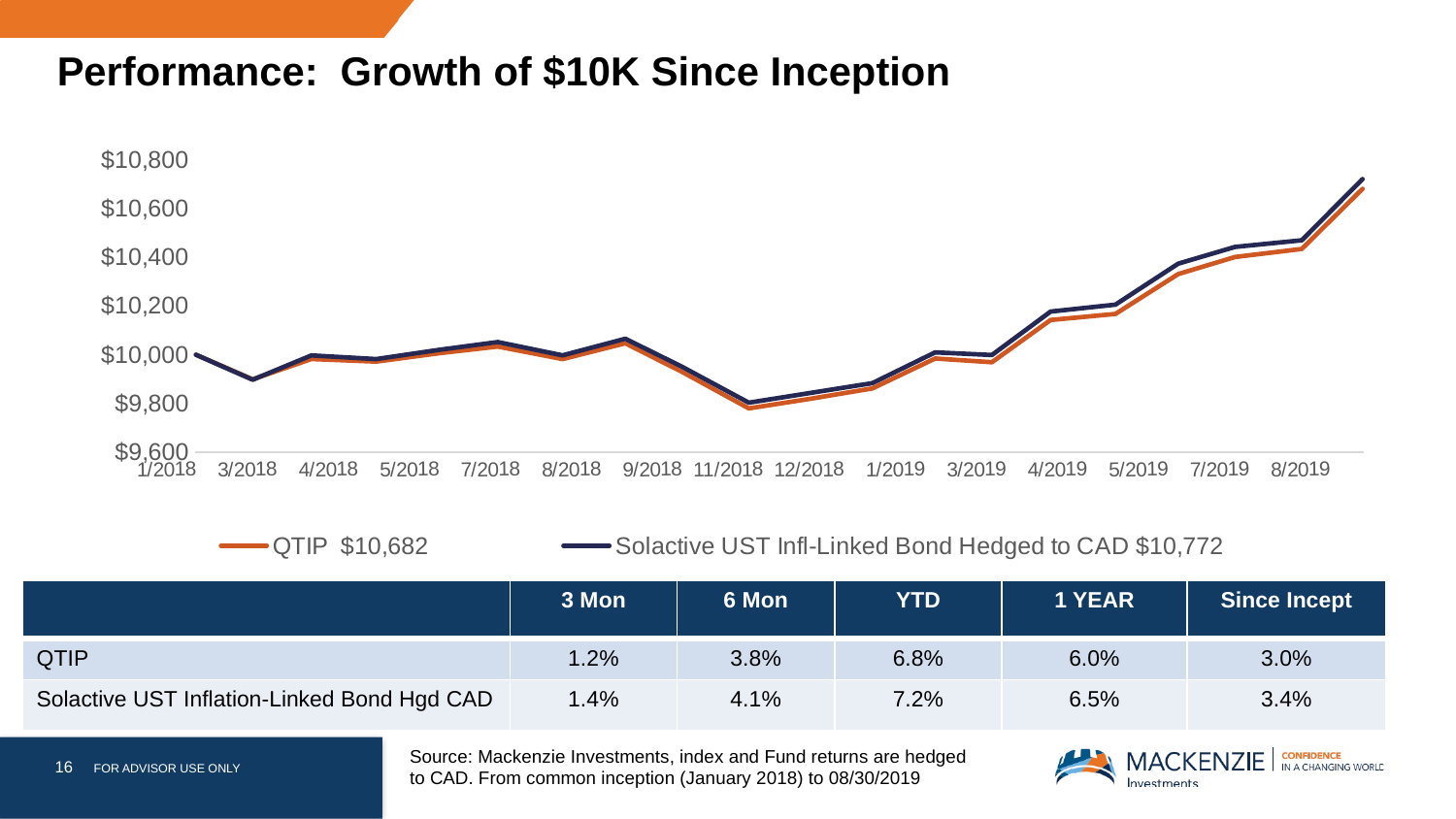
What ending value does the legend show for QTIP? $10,682 What is the difference between the legend values for Solactive UST Infl-Linked Bond Hedged to CAD and QTIP? $90 What ending value does the legend show for Solactive UST Infl-Linked Bond Hedged to CAD? $10,772 At which x-axis date do both lines reach their lowest point? 11/2018 What kind of chart is shown on the slide? line chart Is the QTIP value at 4/2019 greater or less than $10,000? greater What colour is the QTIP line in the chart? orange Is the Solactive UST Infl-Linked Bond Hedged to CAD value at 7/2019 greater or less than $10,200? greater Overall, do the lines rise or fall from the start of the x axis to the end? rise Is the QTIP value at 3/2018 greater or less than $10,000? less Which series ends at a higher value, QTIP or Solactive UST Infl-Linked Bond Hedged to CAD? Solactive UST Infl-Linked Bond Hedged to CAD How many series does the chart legend list? 2